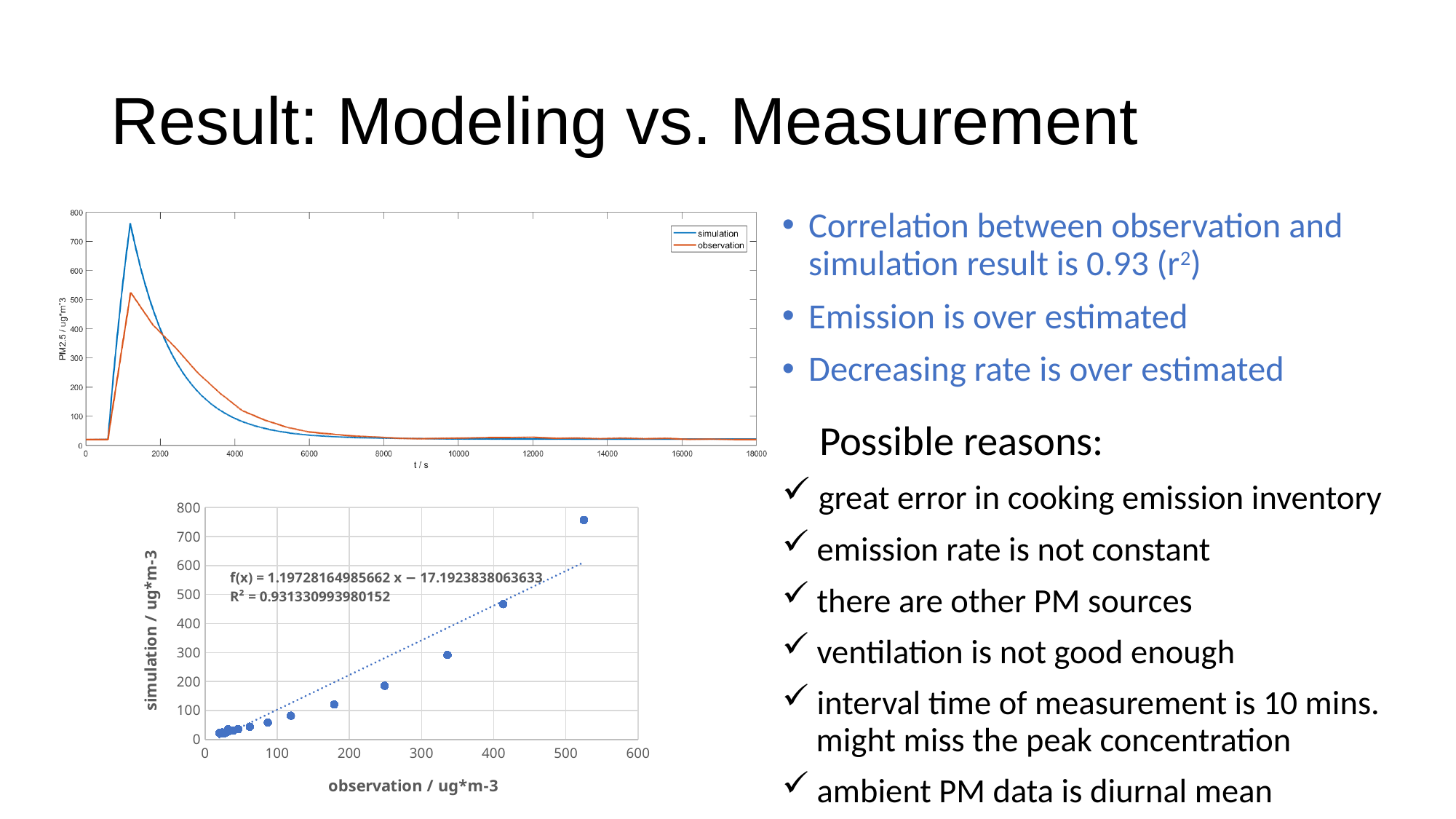
In the bottom chart, what is the R² value shown for the trendline? R² = 0.931330993980152 In the bottom chart, is the simulation value of the highest point greater or less than 700? greater In the bottom chart, what is the trendline equation shown? f(x) = 1.19728164985662 x − 17.1923838063633 In the top chart, is the peak value of the observation series greater or less than 600? less In the top chart, after the peak, do the values rise or fall as t increases? fall In the top chart, is the peak value of the simulation series greater or less than 700? greater In the top chart, what are the two series named in the legend? simulation and observation In the top chart, what is the label of the x axis? t / s In the bottom chart, what kind of chart is it? scatter chart In the top chart, which series reaches the higher peak value? simulation In the top chart, what kind of chart is it? line chart In the top chart, how many series does the legend list? 2